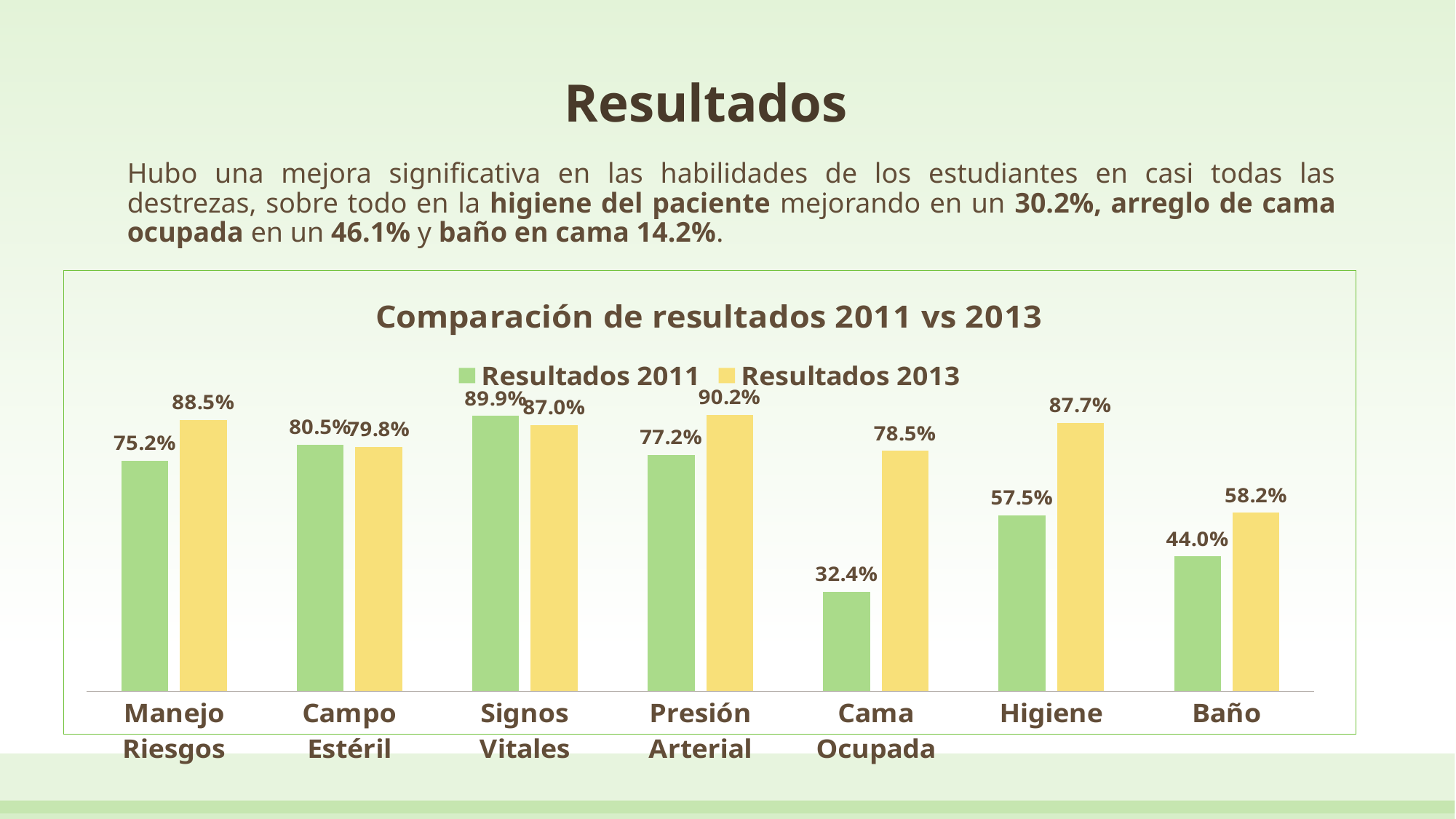
What is the difference between the Resultados 2013 and Resultados 2011 values for Baño? 14.2% What is the title of the chart? Comparación de resultados 2011 vs 2013 What is the Resultados 2013 value for Higiene? 87.7% Which is larger for Campo Estéril: the Resultados 2011 value or the Resultados 2013 value? Resultados 2011 Which category has the highest Resultados 2013 value? Presión Arterial What is the Resultados 2011 value for Cama Ocupada? 32.4% How many series does the legend list? 2 What is the difference between the Resultados 2013 and Resultados 2011 values for Cama Ocupada? 46.1% How many categories are shown on the x axis? 7 What kind of chart is shown? Bar chart What is the Resultados 2011 value for Signos Vitales? 89.9% Which category has the lowest Resultados 2011 value? Cama Ocupada